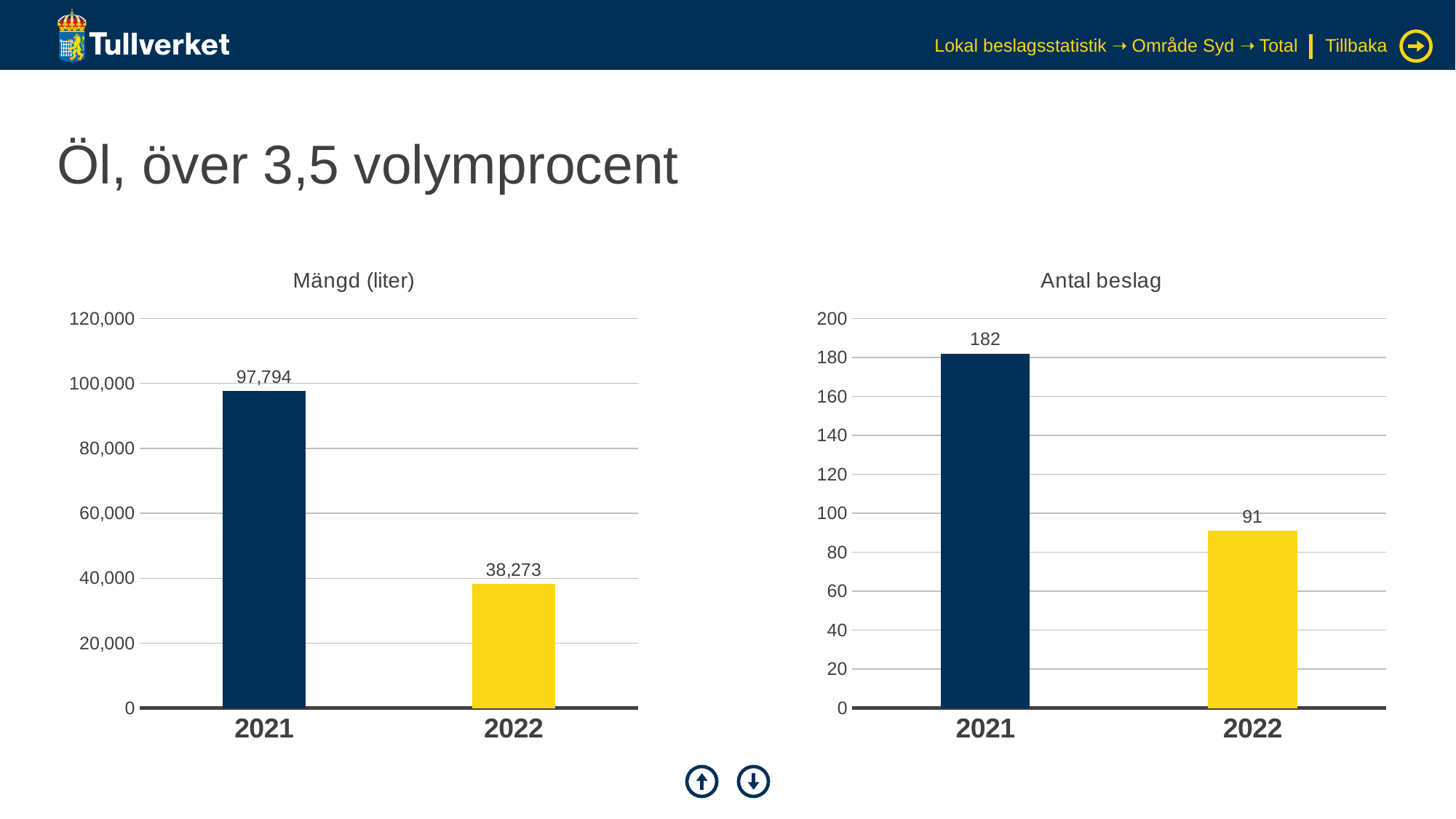
In the 'Antal beslag' chart, is the value for 2021 greater or less than 160? greater In the 'Mängd (liter)' chart, do the values rise or fall from 2021 to 2022? fall In the 'Antal beslag' chart, what is the difference between the 2021 and 2022 values? 91 In the 'Mängd (liter)' chart, what is the value for 2022? 38,273 In the 'Antal beslag' chart, which year has the lowest value? 2022 In the 'Mängd (liter)' chart, what is the value for 2021? 97,794 What kind of chart is the 'Antal beslag' chart? bar chart In the 'Antal beslag' chart, what is the value for 2021? 182 In the 'Mängd (liter)' chart, which year has the highest value? 2021 In the 'Antal beslag' chart, what is the value for 2022? 91 In the 'Mängd (liter)' chart, what is the difference between the 2021 and 2022 values? 59,521 How many years are shown in the 'Mängd (liter)' chart? 2